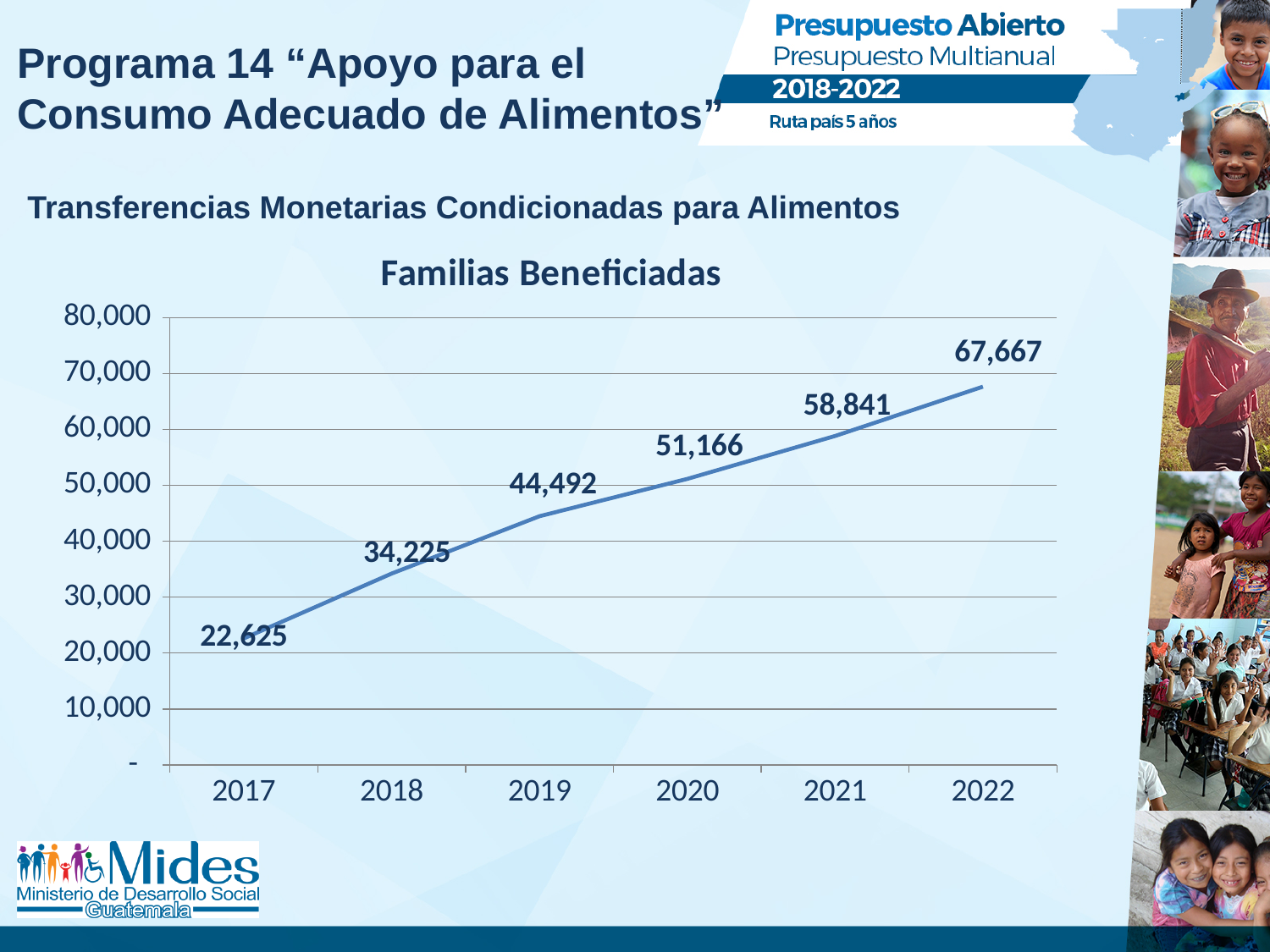
What is the value for 2017 in the Familias Beneficiadas chart? 22,625 Do the values in the Familias Beneficiadas chart rise or fall from 2017 to 2022? rise What kind of chart is the Familias Beneficiadas chart? line chart What is the value for 2020 in the Familias Beneficiadas chart? 51,166 What is the value for 2022 in the Familias Beneficiadas chart? 67,667 What is the difference between the 2022 and 2017 values in the Familias Beneficiadas chart? 45,042 How many years are plotted in the Familias Beneficiadas chart? 6 Which year has the lowest value in the Familias Beneficiadas chart? 2017 Is the value for 2021 in the Familias Beneficiadas chart greater or less than 50,000? greater Which year has the highest value in the Familias Beneficiadas chart? 2022 What is the difference between the 2019 and 2018 values in the Familias Beneficiadas chart? 10,267 Which is larger in the Familias Beneficiadas chart, the value for 2019 or the value for 2021? 2021